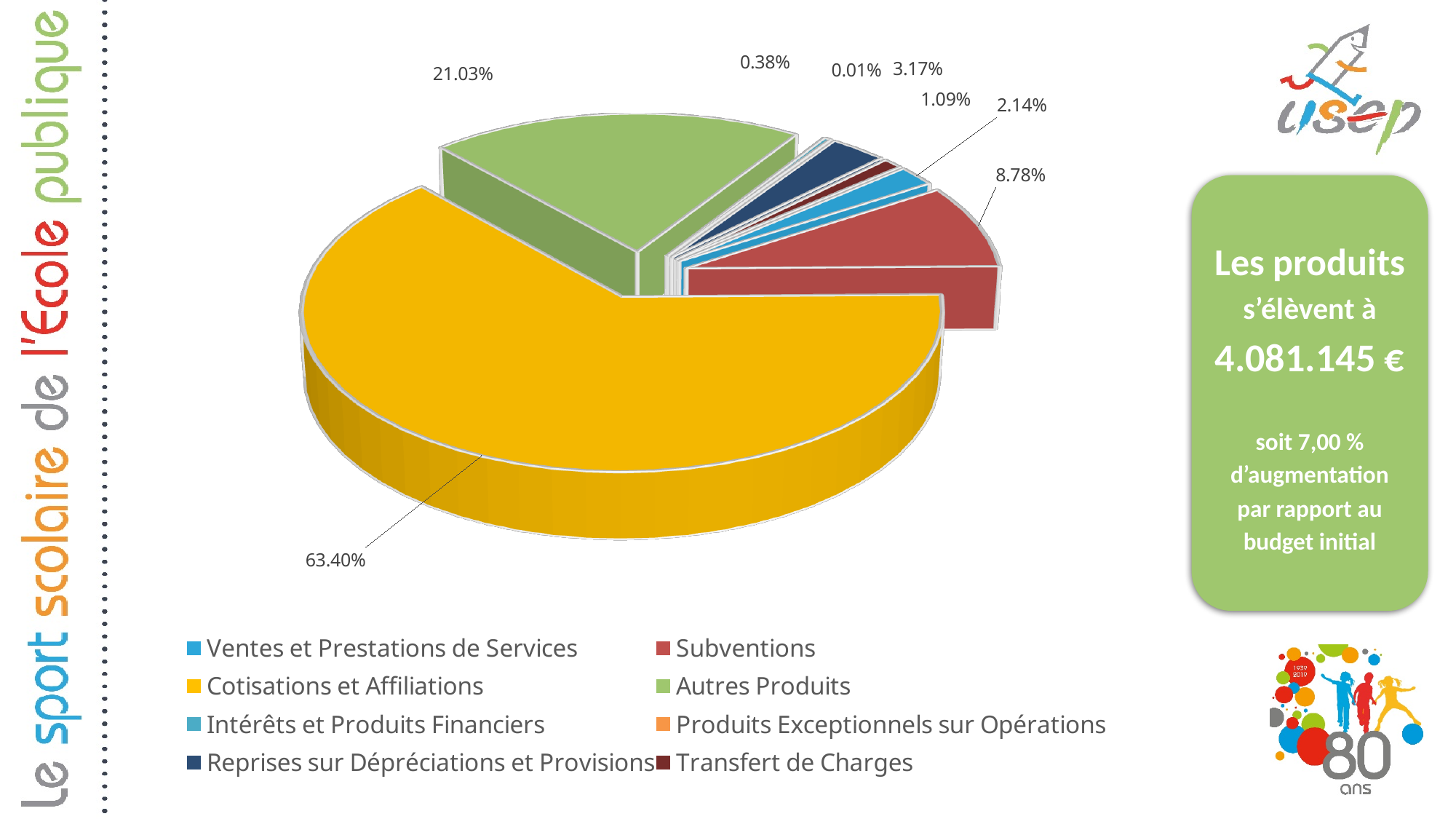
Which is larger, the slice for Subventions or the slice for Autres Produits? Autres Produits What is the difference in percentage points between Cotisations et Affiliations and Autres Produits? 42.37% What is the smallest percentage value labelled on the pie chart? 0.01% What share of the pie does Cotisations et Affiliations represent? 63.40% What percentage is shown for Subventions? 8.78% According to the text box next to the chart, what is the total amount of the products (produits)? 4.081.145 € How many categories does the legend of the pie chart list? 8 What type of chart is shown on the slide? pie chart Which category has the largest slice of the pie? Cotisations et Affiliations What percentage is shown for Autres Produits? 21.03% What percentage is shown for Ventes et Prestations de Services? 2.14% What is the difference in percentage points between Subventions and Ventes et Prestations de Services? 6.64%